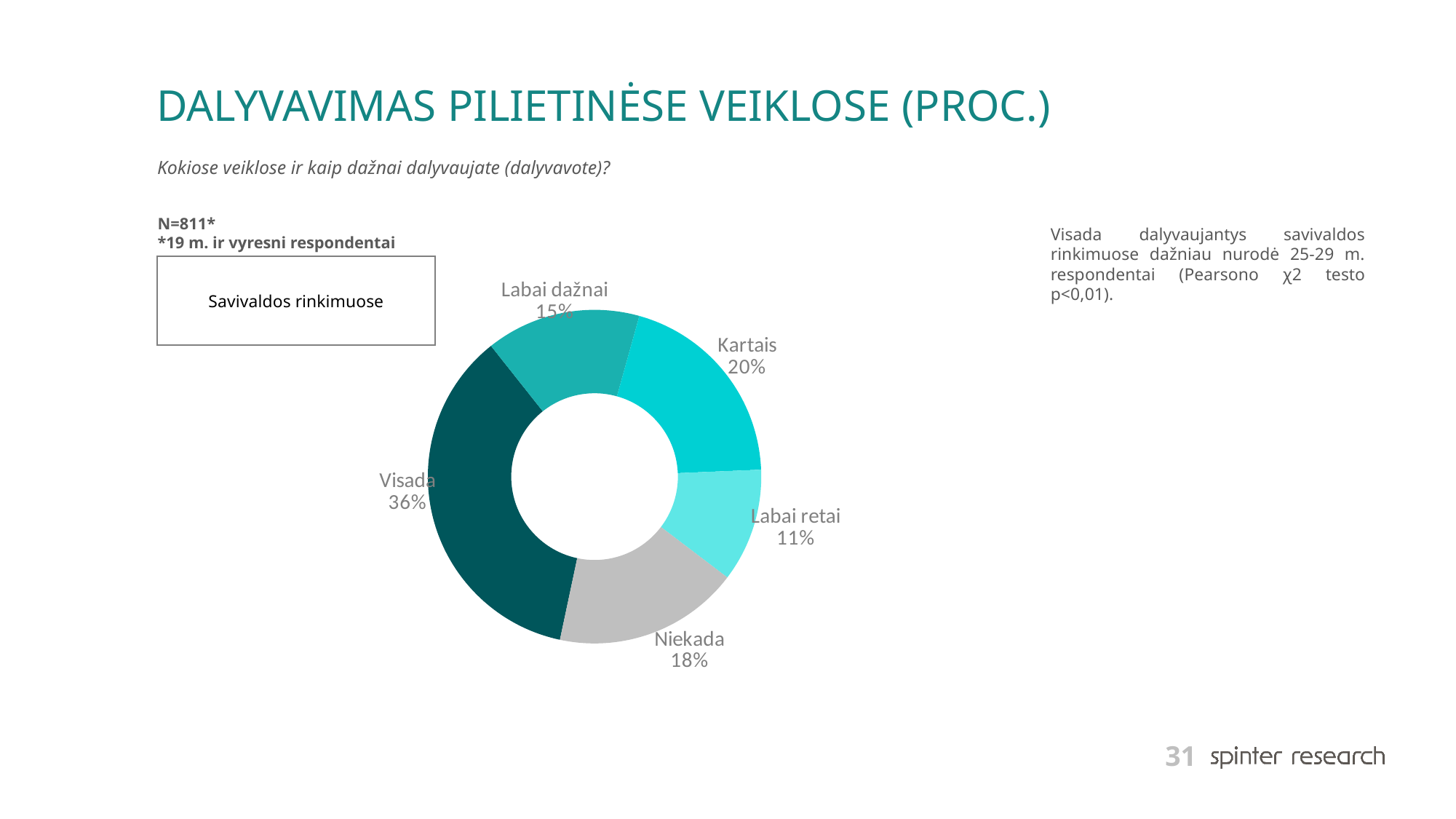
What percentage of respondents answered "Visada" in the Savivaldos rinkimuose chart? 36% How many categories are shown in the pie chart? 5 What share of the pie is labelled "Kartais"? 20% What kind of chart is shown on the slide? Pie chart (doughnut) Which is larger, the share for "Kartais" or the share for "Labai dažnai"? Kartais Which category has the smallest slice of the pie? Labai retai What is the combined share of "Visada" and "Labai dažnai"? 51% What is the value shown for "Niekada"? 18% What is the label in the box above the chart identifying the activity? Savivaldos rinkimuose What is the value shown for "Labai retai"? 11% Which category has the largest slice of the pie? Visada What is the difference in percentage points between "Visada" and "Niekada"? 18